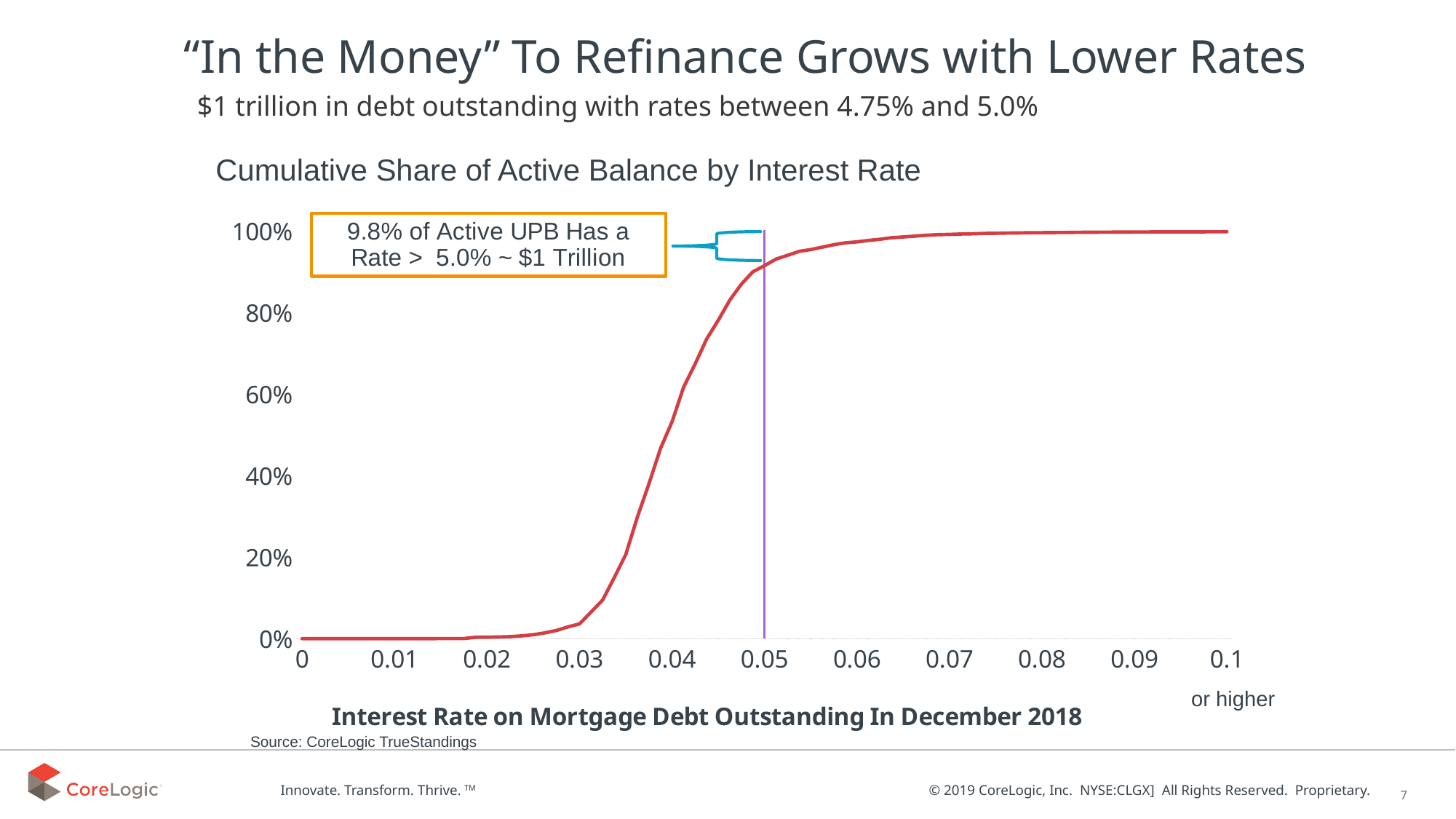
According to the annotation on the chart, what share of active UPB has a rate greater than 5.0%? 9.8% Which is larger, the cumulative share at 0.03 or at 0.04? 0.04 What kind of chart is shown on the slide? Line chart What is the title of the chart? Cumulative Share of Active Balance by Interest Rate Is the cumulative share at an interest rate of 0.02 greater or less than 20%? less Is the cumulative share at an interest rate of 0.06 greater or less than 80%? greater Is the cumulative share at an interest rate of 0.05 greater or less than 80%? greater Does the cumulative share rise or fall as the interest rate increases along the x axis? Rise What is the x-axis label of the chart? Interest Rate on Mortgage Debt Outstanding In December 2018 How many tick labels are shown on the x axis of the chart? 11